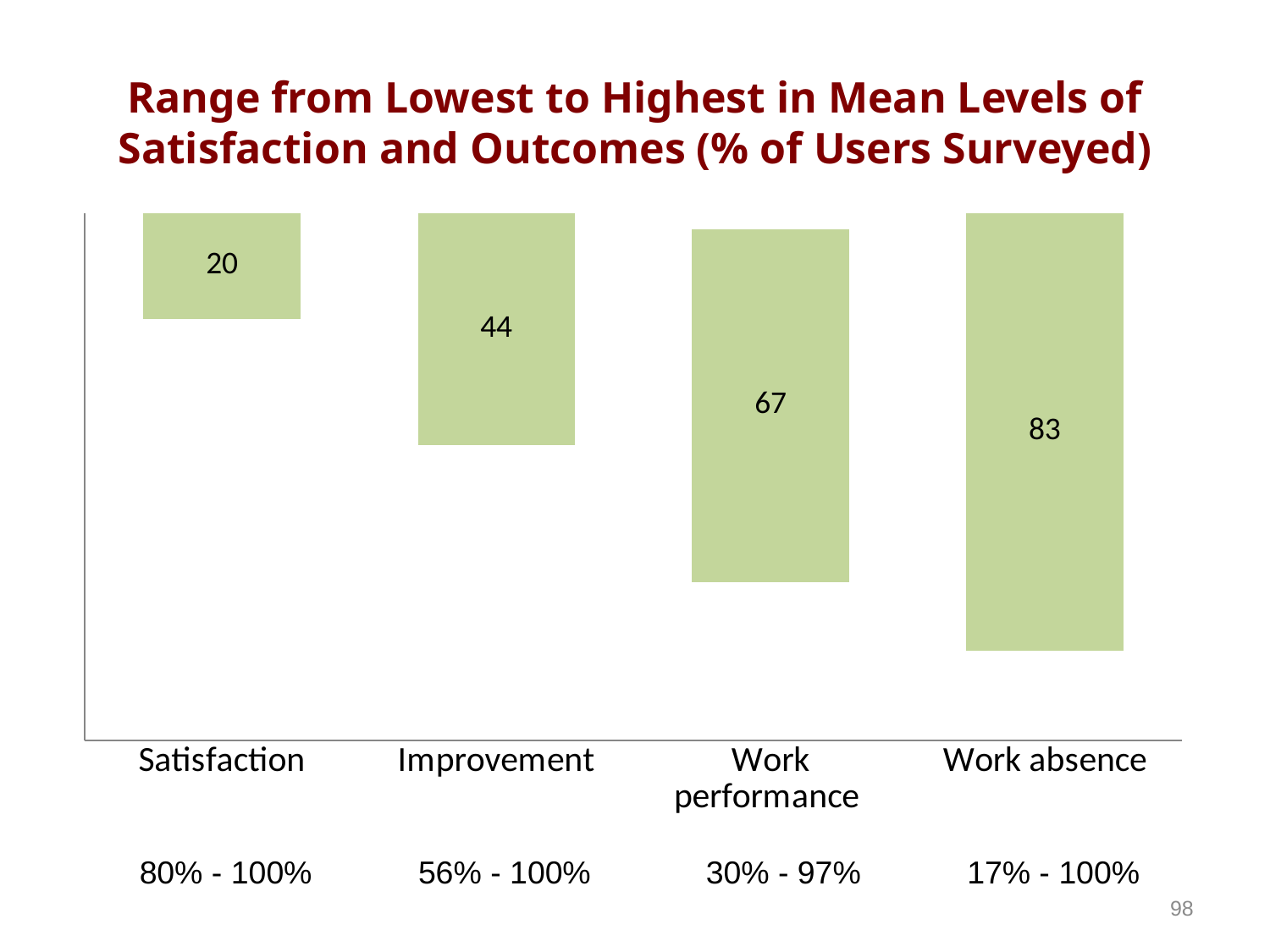
What range is printed beneath the Work performance category? 30% - 97% What kind of chart is shown on the slide? Bar chart Do the labelled bar values rise or fall from left to right across the categories? Rise Which category has the largest value labelled on its bar? Work absence What is the value shown on the bar for Work absence? 83 What is the value shown on the bar for Work performance? 67 Which category has the smallest value labelled on its bar? Satisfaction What is the difference between the values labelled for Work performance and Improvement? 23 How many categories are shown on the x axis? 4 What is the value shown on the bar for Satisfaction? 20 Which has a larger labelled value, Improvement or Work performance? Work performance What is the difference between the values labelled for Work absence and Satisfaction? 63